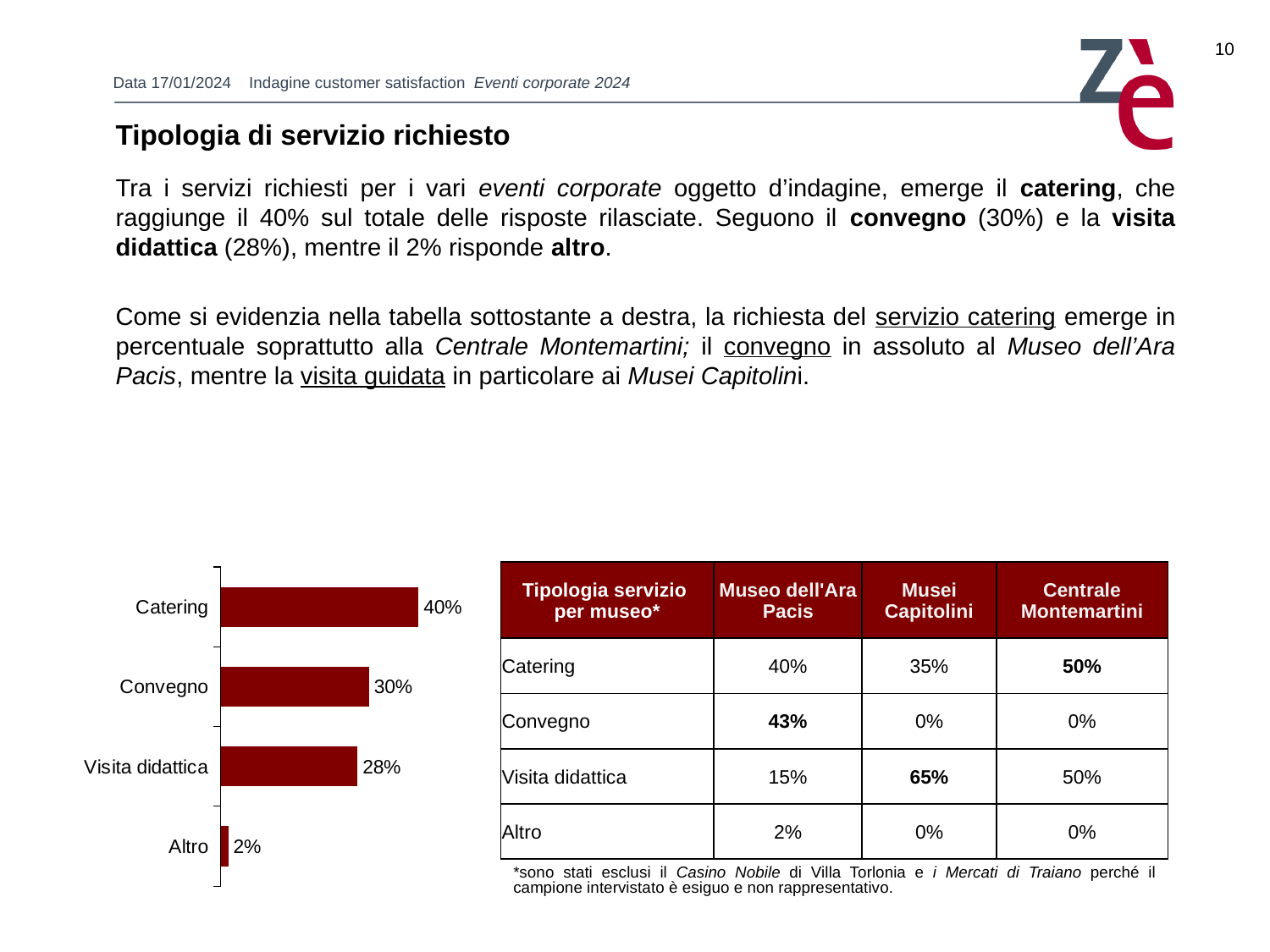
What is the difference between the values for Catering and Convegno in the bar chart? 10% What colour are the bars in the bar chart? Dark red What is the value for Visita didattica in the bar chart? 28% What kind of chart is shown on the slide? Bar chart Which category has the highest value in the bar chart? Catering How many categories are shown in the bar chart? 4 Which category has the lowest value in the bar chart? Altro What is the value for Convegno in the bar chart? 30% What is the value for Catering in the bar chart? 40% In the bar chart, which is larger: the value for Convegno or the value for Altro? Convegno What is the value for Altro in the bar chart? 2% What is the difference between the values for Convegno and Visita didattica in the bar chart? 2%